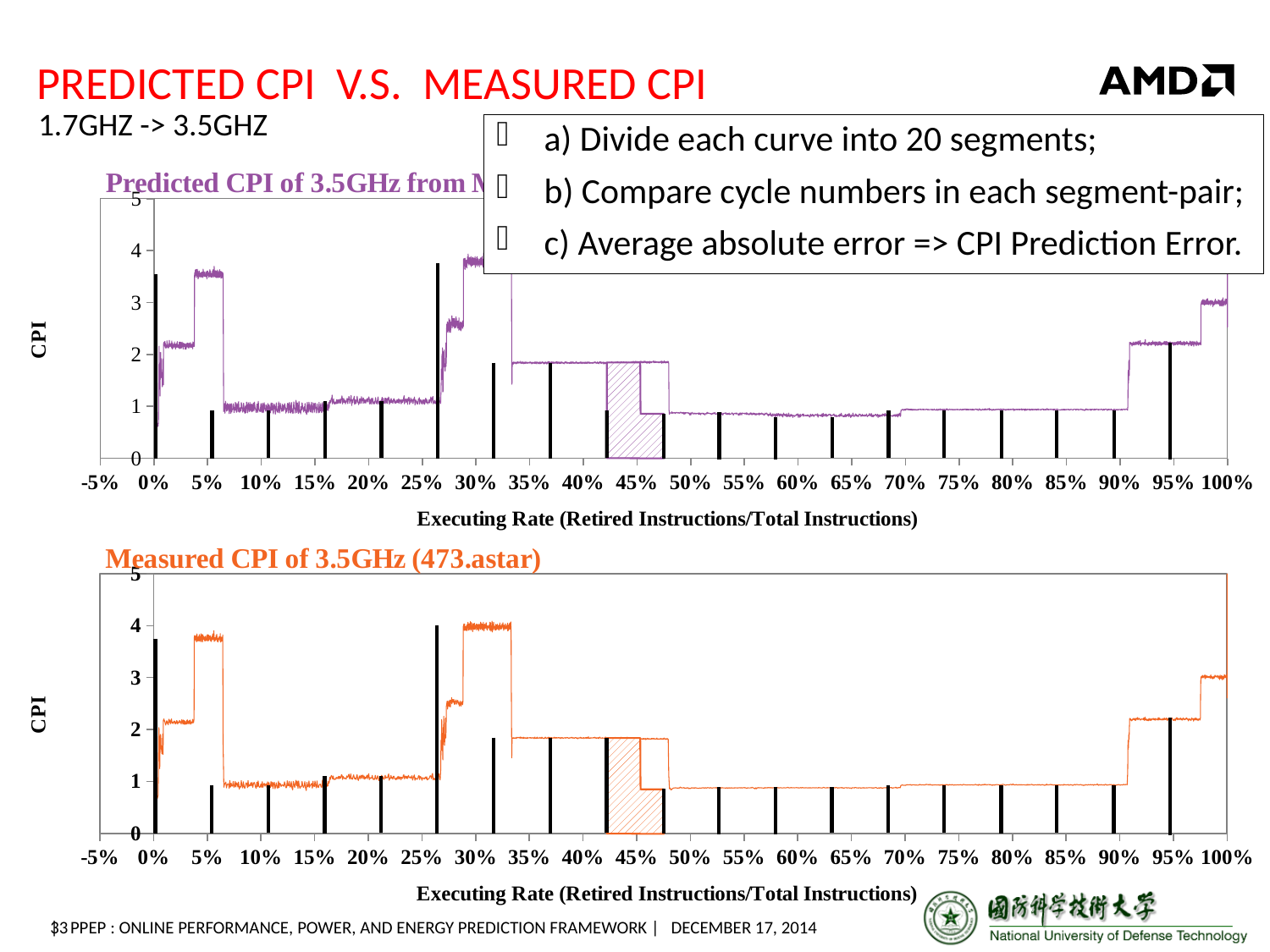
In the top chart (Predicted CPI of 3.5GHz), is the CPI value at an executing rate of 5% greater or less than 3? greater In the bottom chart (Measured CPI of 3.5GHz), does the curve rise or fall between an executing rate of 45% and 50%? fall In the bottom chart (Measured CPI of 3.5GHz), is the CPI value at an executing rate of 30% greater or less than 3? greater In the bottom chart (Measured CPI of 3.5GHz), is the CPI value at an executing rate of 60% greater or less than 2? less In the bottom chart (Measured CPI of 3.5GHz), does the curve rise or fall between an executing rate of 25% and 30%? rise What kind of chart is the bottom chart titled "Measured CPI of 3.5GHz (473.astar)"? line chart In the bottom chart (Measured CPI of 3.5GHz), what is the label of the y axis? CPI In the bottom chart (Measured CPI of 3.5GHz), what is the highest value shown on the y axis? 5 How many charts are shown on the slide? 2 In the bottom chart (Measured CPI of 3.5GHz), what is the label of the x axis? Executing Rate (Retired Instructions/Total Instructions)